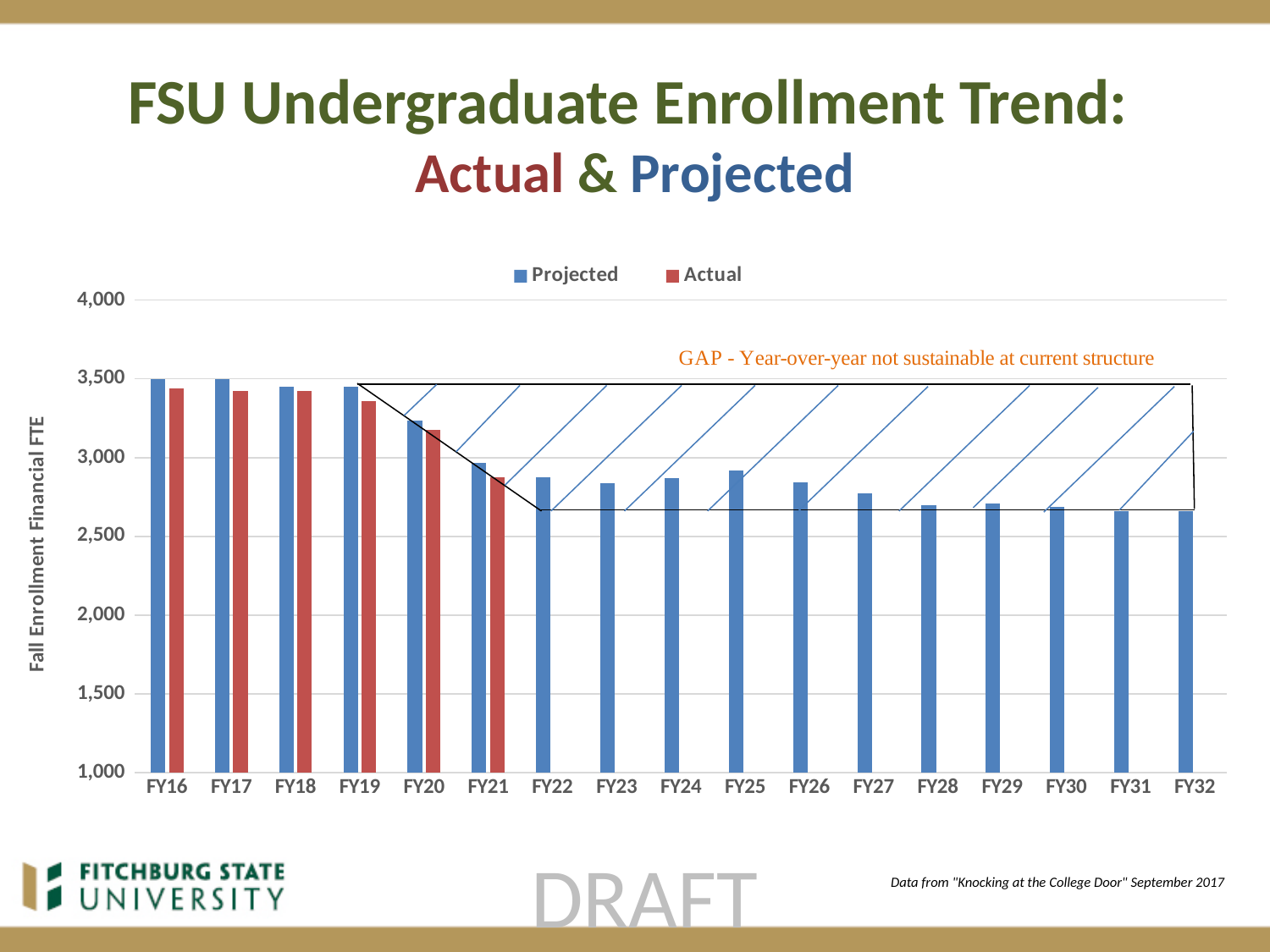
Is the Projected value for FY32 greater or less than 2,500? greater Is the Actual value for FY21 greater or less than 3,000? less Which fiscal year has the lowest Actual value? FY21 How many fiscal year categories are shown on the x axis? 17 Is the Projected value for FY20 greater or less than 3,000? greater What is the label on the vertical axis? Fall Enrollment Financial FTE What kind of chart is shown on the slide? Bar chart Which is larger, the Projected value for FY16 or the Projected value for FY32? FY16 Do the Actual values rise or fall from FY16 to FY21? fall How many series does the legend list? 2 Which is larger, the Actual value for FY20 or the Actual value for FY21? FY20